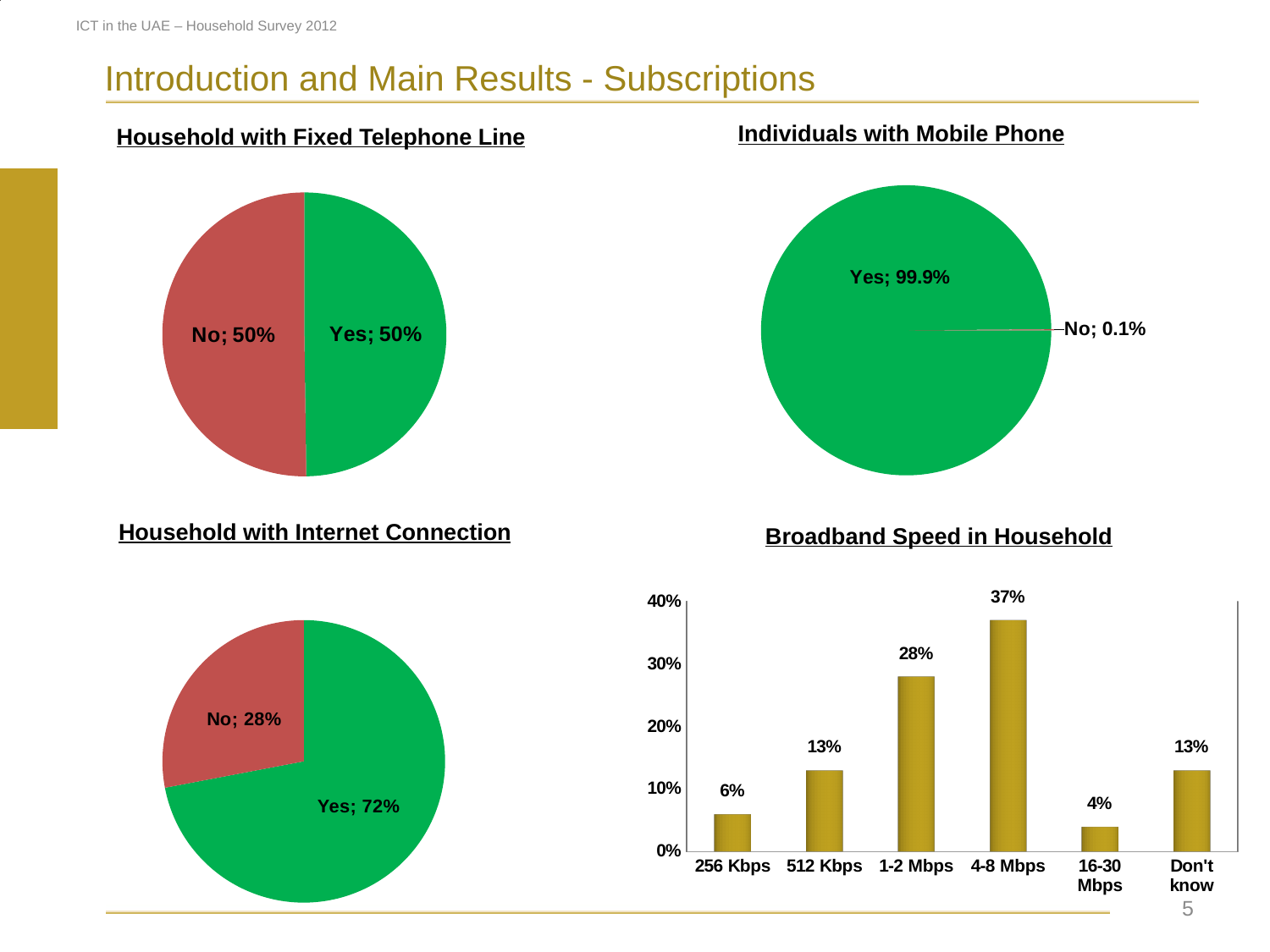
In the 'Household with Internet Connection' chart, what is the difference between the Yes and No shares? 44% In the 'Broadband Speed in Household' chart, how many categories are shown on the x axis? 6 In the 'Individuals with Mobile Phone' chart, what is the value for Yes? 99.9% In the 'Household with Fixed Telephone Line' chart, what percentage of households answered Yes? 50% In the 'Household with Internet Connection' chart, what percentage of households answered No? 28% In the 'Broadband Speed in Household' chart, what is the difference between the values for 4-8 Mbps and 256 Kbps? 31% What type of chart is 'Broadband Speed in Household'? Bar chart In the 'Broadband Speed in Household' chart, is the value for 512 Kbps larger or smaller than the value for 1-2 Mbps? Smaller In the 'Broadband Speed in Household' chart, which category has the highest value? 4-8 Mbps In the 'Broadband Speed in Household' chart, what is the value for 1-2 Mbps? 28% In the 'Individuals with Mobile Phone' chart, what is the value for No? 0.1% In the 'Broadband Speed in Household' chart, which category has the lowest value? 16-30 Mbps